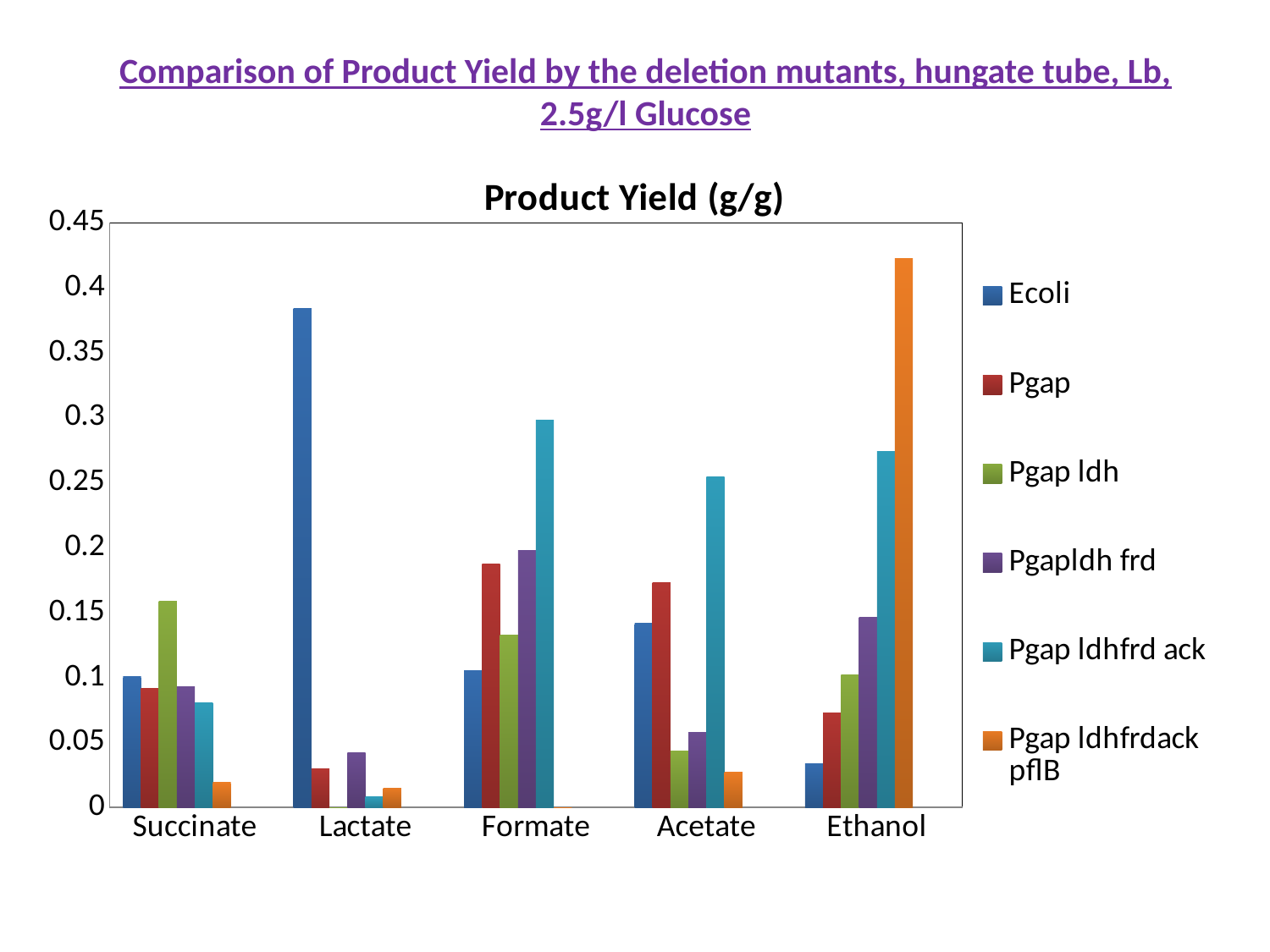
What is the title of the chart? Product Yield (g/g) How many series does the legend list? 6 Is the Pgap ldhfrdack pflB value for Ethanol greater or less than 0.4? greater What kind of chart is shown on the slide? bar chart Is the Pgap ldhfrd ack value for Acetate greater or less than 0.2? greater For Ethanol, which series has the highest product yield? Pgap ldhfrdack pflB For Succinate, which series has the highest product yield? Pgap ldh Is the Ecoli value for Lactate greater or less than 0.35? greater How many product categories are shown on the x axis? 5 For Formate, which is larger: the Pgap ldhfrd ack value or the Ecoli value? Pgap ldhfrd ack For Acetate, which is larger: the Pgap value or the Pgap ldh value? Pgap For Lactate, which series has the highest product yield? Ecoli